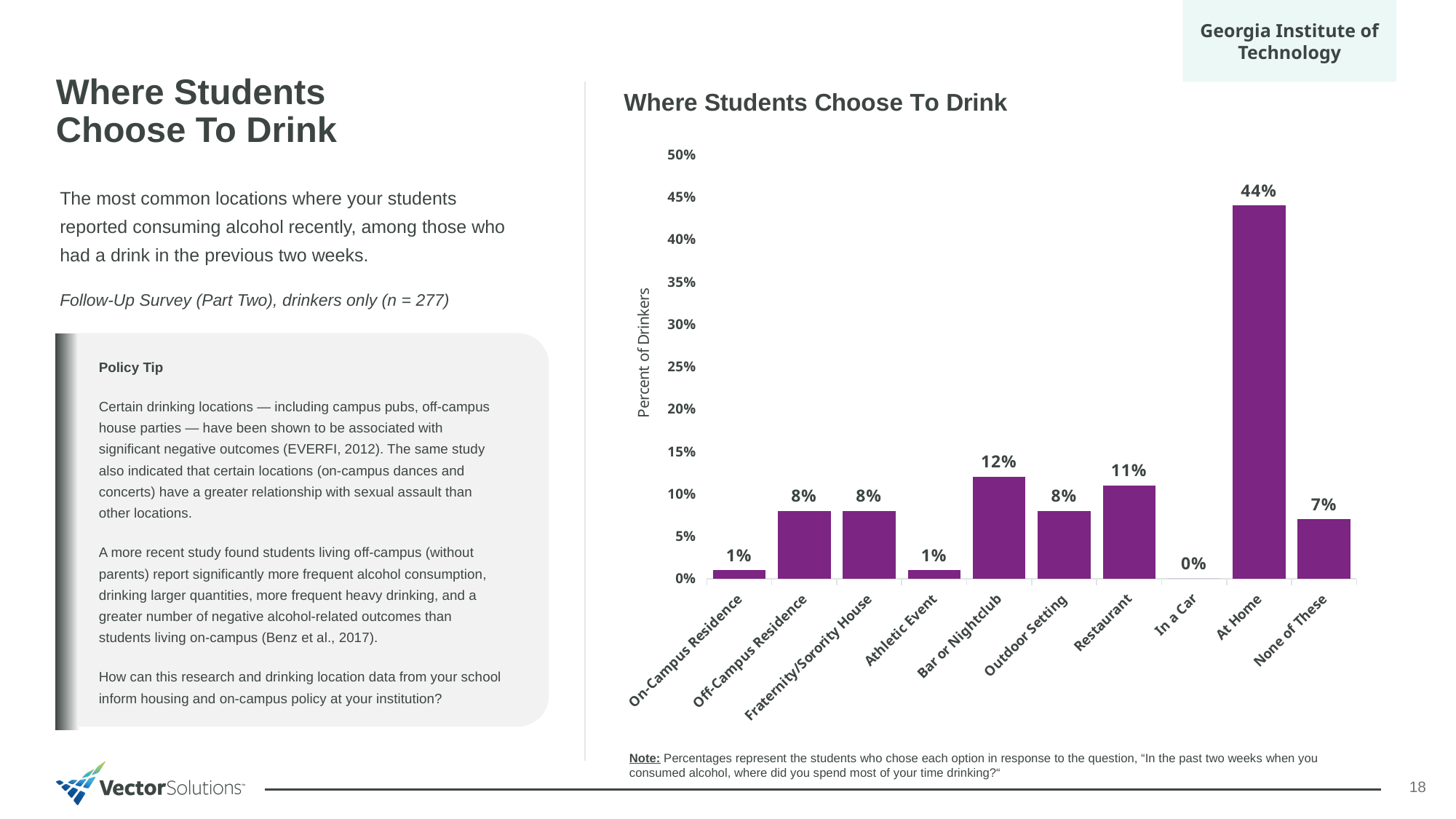
What is the value for Bar or Nightclub? 12% What percentage of drinkers chose Restaurant? 11% What percentage of drinkers chose At Home? 44% Is the value for At Home greater or less than 40%? greater Which location has the lowest percentage of drinkers? In a Car What is the difference between the values for At Home and Bar or Nightclub? 32% What is the value for In a Car? 0% Which is larger, the value for Restaurant or the value for None of These? Restaurant What is the label of the y axis? Percent of Drinkers How many location categories are shown on the x axis? 10 What kind of chart is shown on the slide? bar chart Which location has the highest percentage of drinkers? At Home